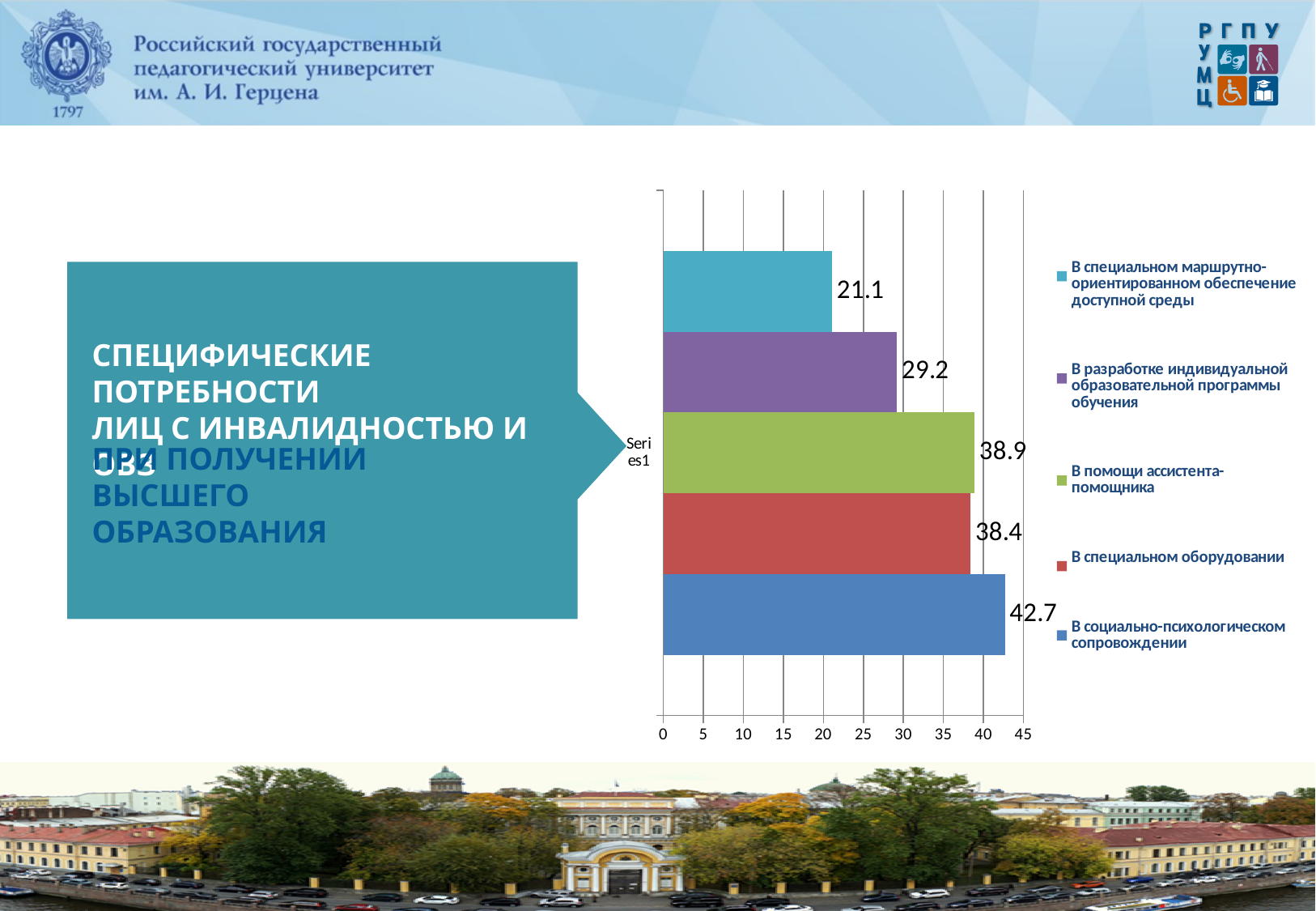
Which legend entry has the highest value? В социально-психологическом сопровождении What type of chart is shown on the slide? Bar chart What value is shown for "В помощи ассистента-помощника"? 38.9 What is the difference between the values for "В социально-психологическом сопровождении" and "В специальном маршрутно-ориентированном обеспечении доступной среды"? 21.6 What value is shown for "В социально-психологическом сопровождении"? 42.7 What value is shown for "В разработке индивидуальной образовательной программы обучения"? 29.2 Which legend entry has the lowest value? В специальном маршрутно-ориентированном обеспечении доступной среды What value is shown for "В специальном маршрутно-ориентированном обеспечении доступной среды"? 21.1 Which is larger: the value for "В разработке индивидуальной образовательной программы обучения" or the value for "В специальном оборудовании"? В специальном оборудовании How many bars are plotted in the chart? 5 How many entries does the chart legend list? 5 What value is shown for "В специальном оборудовании"? 38.4